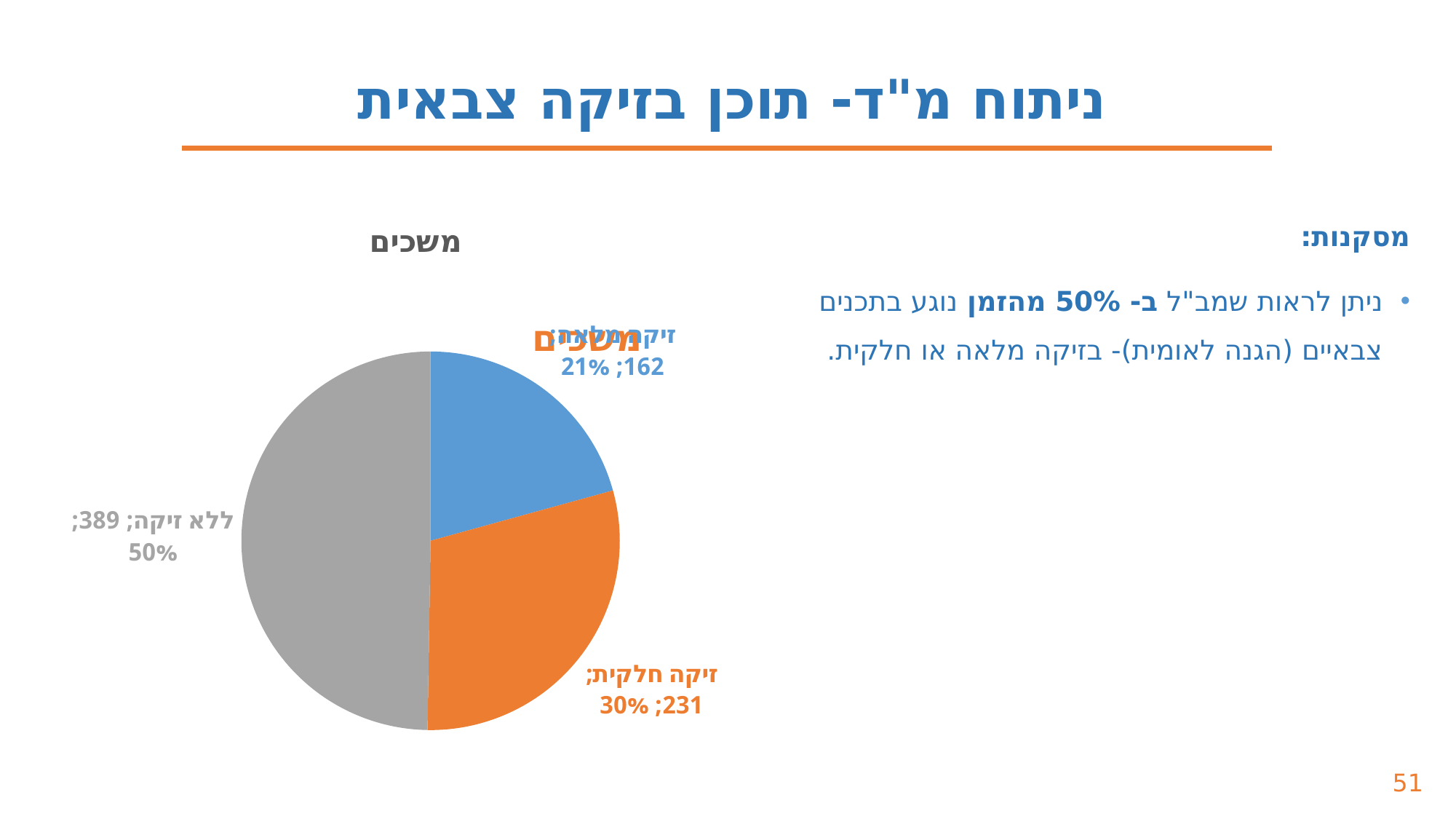
What is the difference between the values for ללא זיקה and זיקה חלקית? 158 What kind of chart is shown on the slide? pie chart What is the value shown for the blue slice of the pie chart? 162 What is the title of the pie chart? משכים What is the value shown for זיקה חלקית in the pie chart? 231 What percentage share does זיקה חלקית have in the pie chart? 30% What percentage share does the blue slice have in the pie chart? 21% What is the value shown for ללא זיקה in the pie chart? 389 Which category has the largest slice in the pie chart? ללא זיקה Which is larger in the pie chart, זיקה חלקית or the blue slice? זיקה חלקית What percentage share does ללא זיקה have in the pie chart? 50% How many slices does the pie chart have? 3